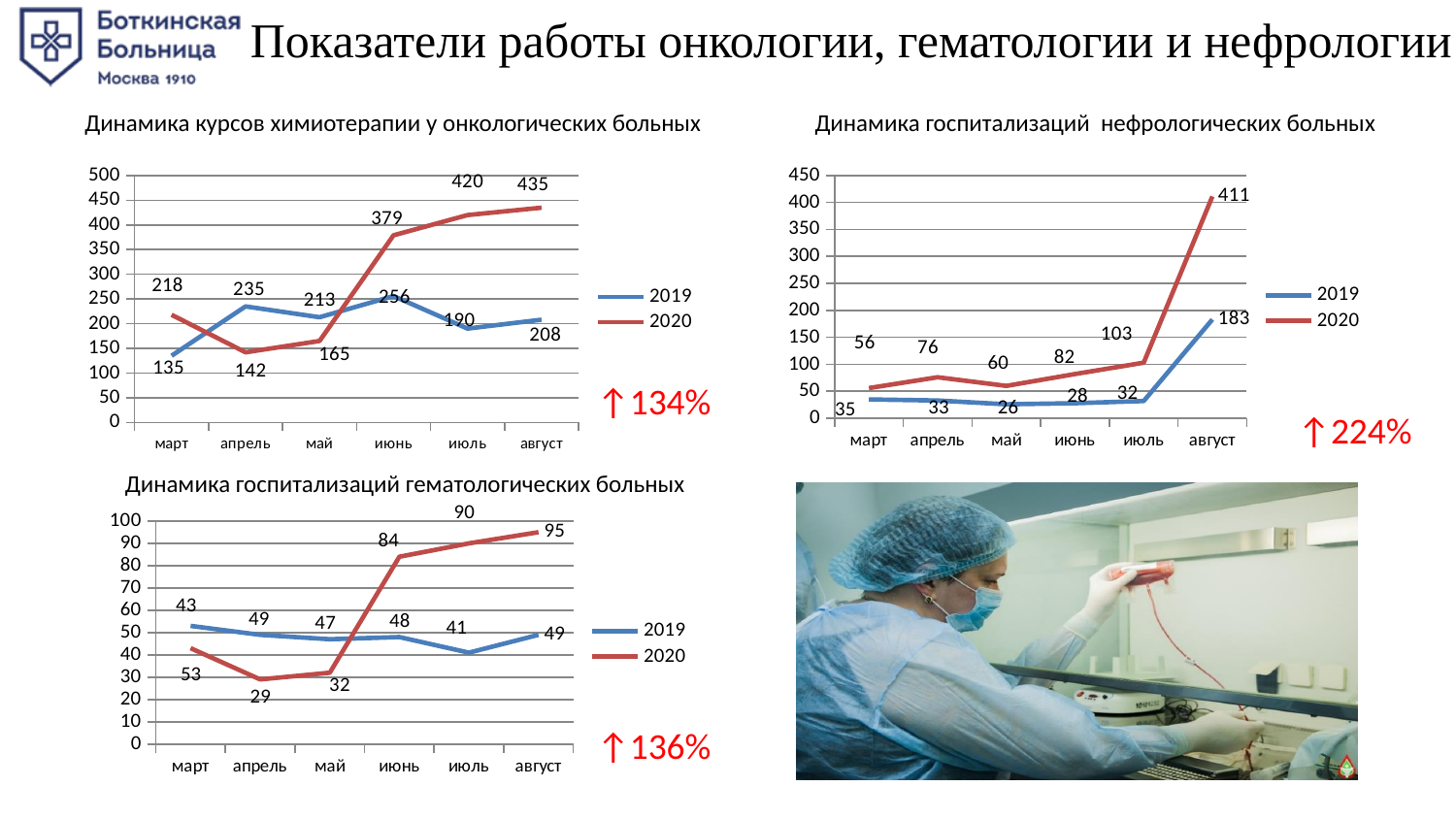
On the chart 'Динамика курсов химиотерапии у онкологических больных', what is the difference between the 2020 and 2019 values for июль? 230 On the chart 'Динамика госпитализаций нефрологических больных', which month has the lowest 2019 value? май On the chart 'Динамика курсов химиотерапии у онкологических больных', which month has the highest 2020 value? август What type of chart is 'Динамика госпитализаций нефрологических больных'? line chart On the chart 'Динамика госпитализаций нефрологических больных', what is the 2020 value for август? 411 On the chart 'Динамика курсов химиотерапии у онкологических больных', what is the 2019 value for июнь? 256 On the chart 'Динамика госпитализаций гематологических больных', which is larger for июль, the 2019 value or the 2020 value? 2020 On the chart 'Динамика курсов химиотерапии у онкологических больных', what is the 2020 value for август? 435 On the chart 'Динамика госпитализаций нефрологических больных', what is the 2019 value for май? 26 On the chart 'Динамика госпитализаций гематологических больных', what is the 2020 value for июнь? 84 On the chart 'Динамика госпитализаций нефрологических больных', is the 2020 value for июль greater or less than 150? less How many months are shown on the x axis of the chart 'Динамика госпитализаций гематологических больных'? 6